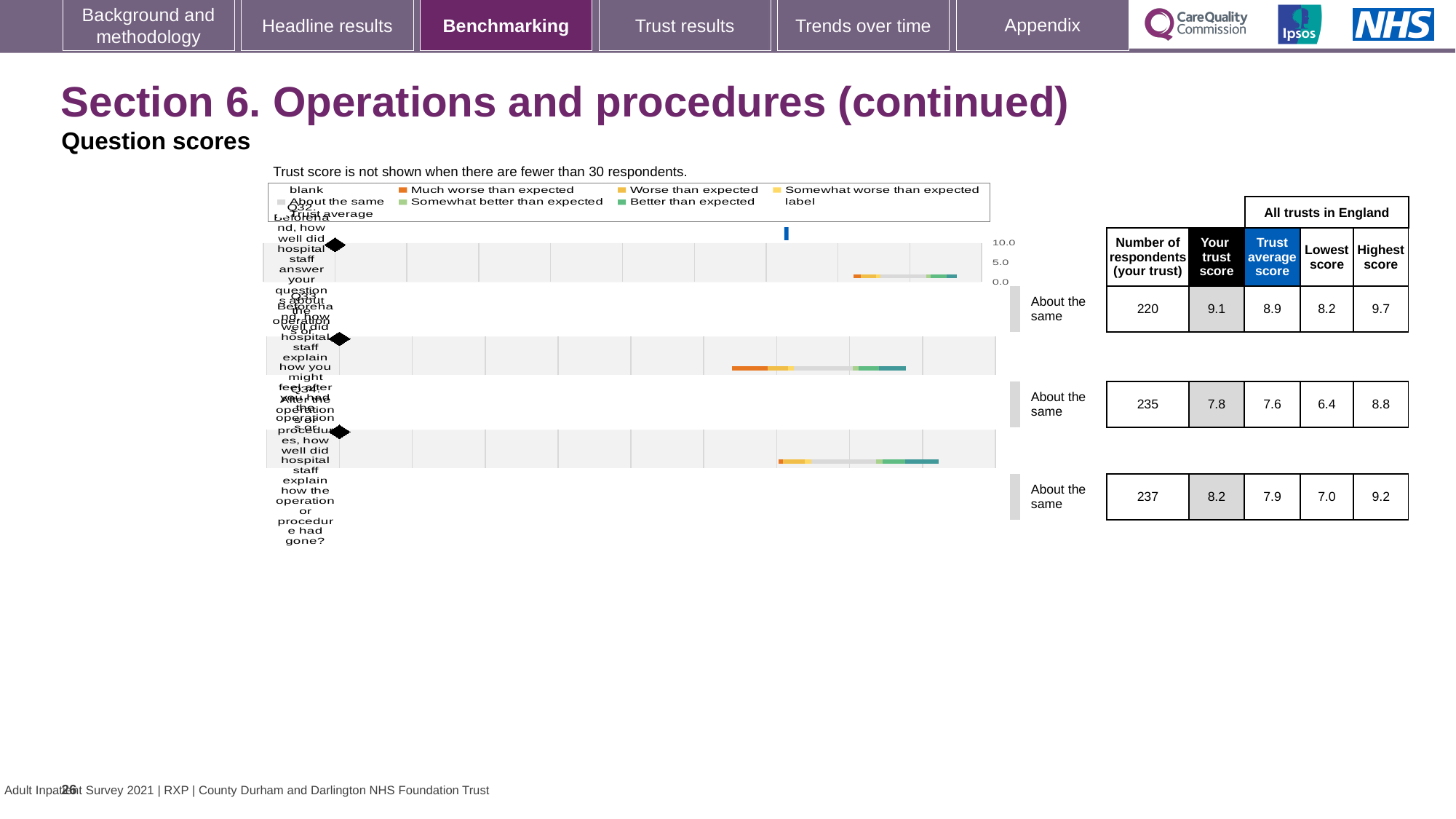
In the table, what is the 'Lowest score' for the second row (Q33)? 6.4 In the table, what is the 'Highest score' for the third row (Q34)? 9.2 What kind of chart is shown on the slide? bar chart For the first row (Q32), what is the difference between 'Your trust score' and 'Trust average score'? 0.2 Which row has the highest 'Your trust score' in the table? the first row (Q32), 9.1 In the table, what is 'Your trust score' for the second row (Q33)? 7.8 According to the note above the chart, when is the trust score not shown? when there are fewer than 30 respondents In the table, what is the number of respondents for the first row (Q32)? 220 How many question rows are plotted in the chart? 3 For the third row (Q34), what is the difference between the 'Highest score' and the 'Lowest score'? 2.2 What benchmark category is shown for all three question rows? About the same For the second row (Q33), which is larger: 'Your trust score' or 'Trust average score'? Your trust score